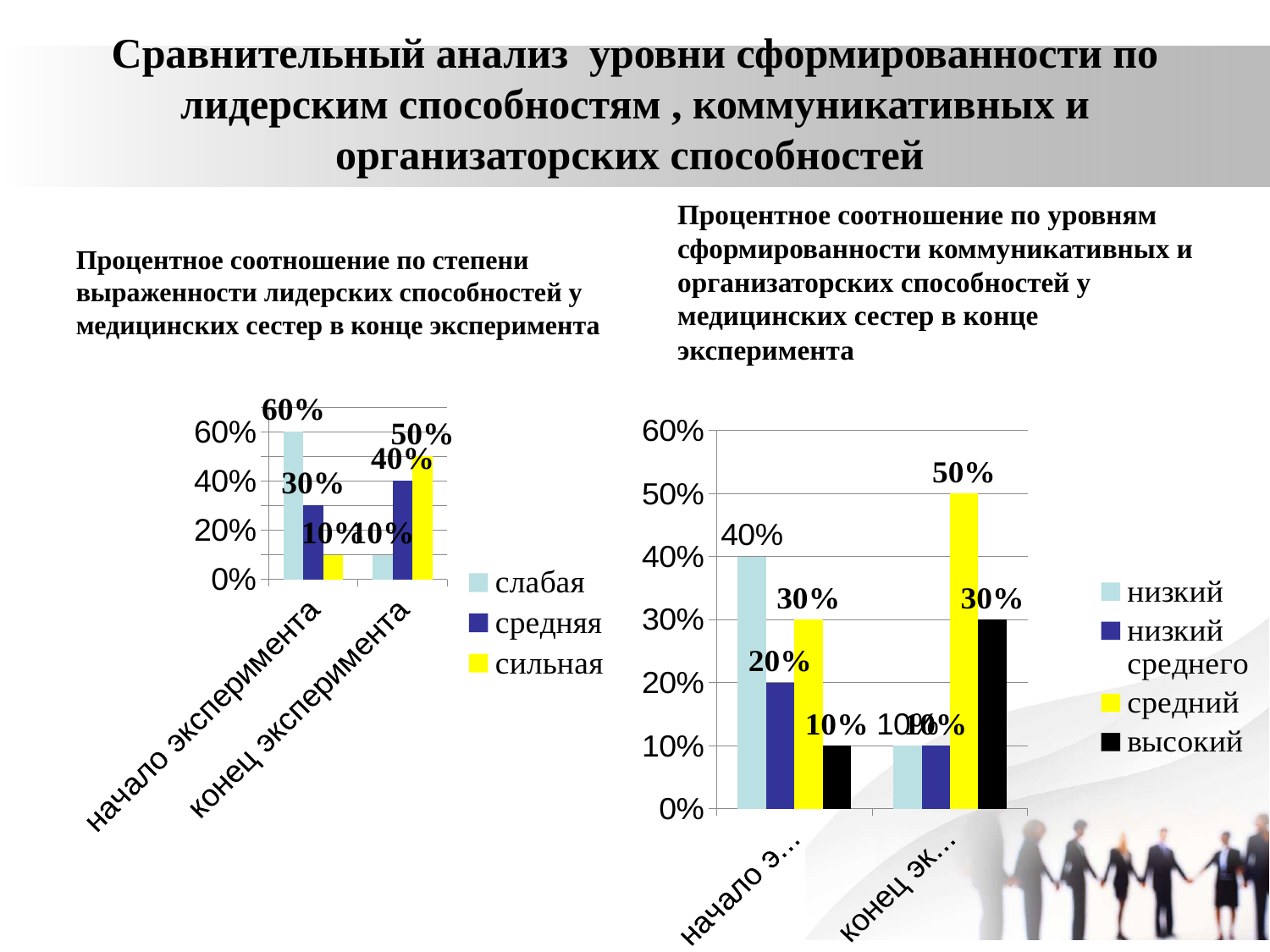
In the right chart (коммуникативные и организаторские способности), what is the value for низкий in the начало category? 40% In the right chart (коммуникативные и организаторские способности), which series has the lowest value in the начало category? высокий In the left chart (лидерские способности), what is the difference between слабая at начало эксперимента and слабая at конец эксперимента? 50% In the left chart (лидерские способности), how many series does the legend list? 3 In the right chart (коммуникативные и организаторские способности), which is larger: высокий in the начало category or высокий in the конец category? конец In the left chart (лидерские способности), what is the value for слабая at начало эксперимента? 60% What type of chart is the right chart (коммуникативные и организаторские способности)? bar chart In the left chart (лидерские способности), does the value for сильная rise or fall from начало эксперимента to конец эксперимента? rise In the right chart (коммуникативные и организаторские способности), what is the value for средний in the конец category? 50% In the left chart (лидерские способности), what is the value for сильная at конец эксперимента? 50% In the left chart (лидерские способности), what is the value for средняя at конец эксперимента? 40% In the left chart (лидерские способности), which series has the highest value at начало эксперимента? слабая